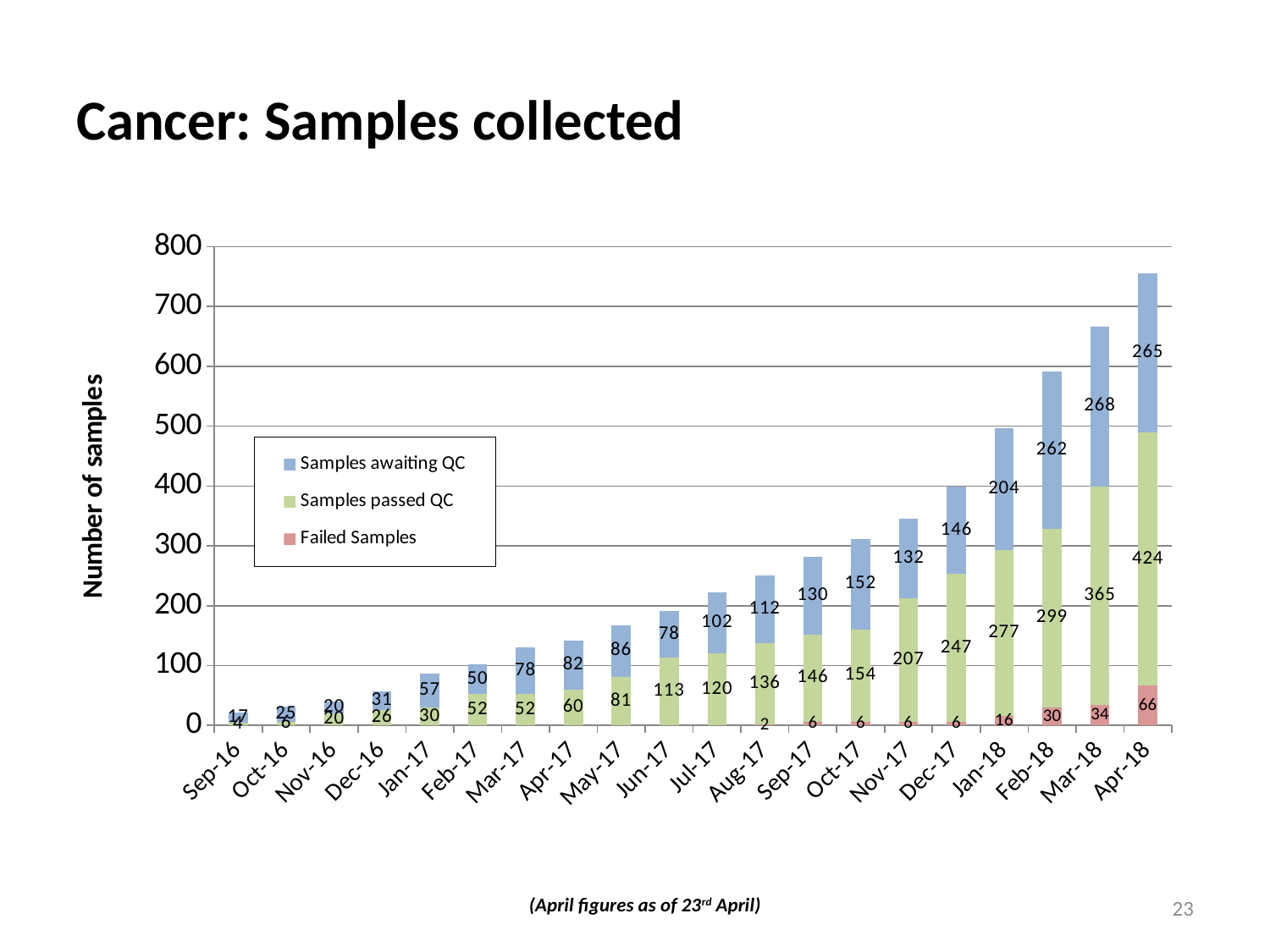
What is the difference between Samples passed QC in Apr-18 and Mar-18? 59 Do the total samples collected rise or fall from Sep-16 to Apr-18? Rise What type of chart is shown on the slide? Stacked bar chart How many months are shown along the x axis? 20 Which is larger in Feb-18: Samples awaiting QC or Samples passed QC? Samples passed QC Which month has the highest value for Failed Samples? Apr-18 What is the total height of the stacked bar for Apr-18? 755 Which month has the highest value for Samples passed QC? Apr-18 What is the value of Samples awaiting QC for Mar-18? 268 What is the value of Samples passed QC for Apr-18? 424 How many series does the legend list? 3 What is the value of Failed Samples for Jan-18? 16